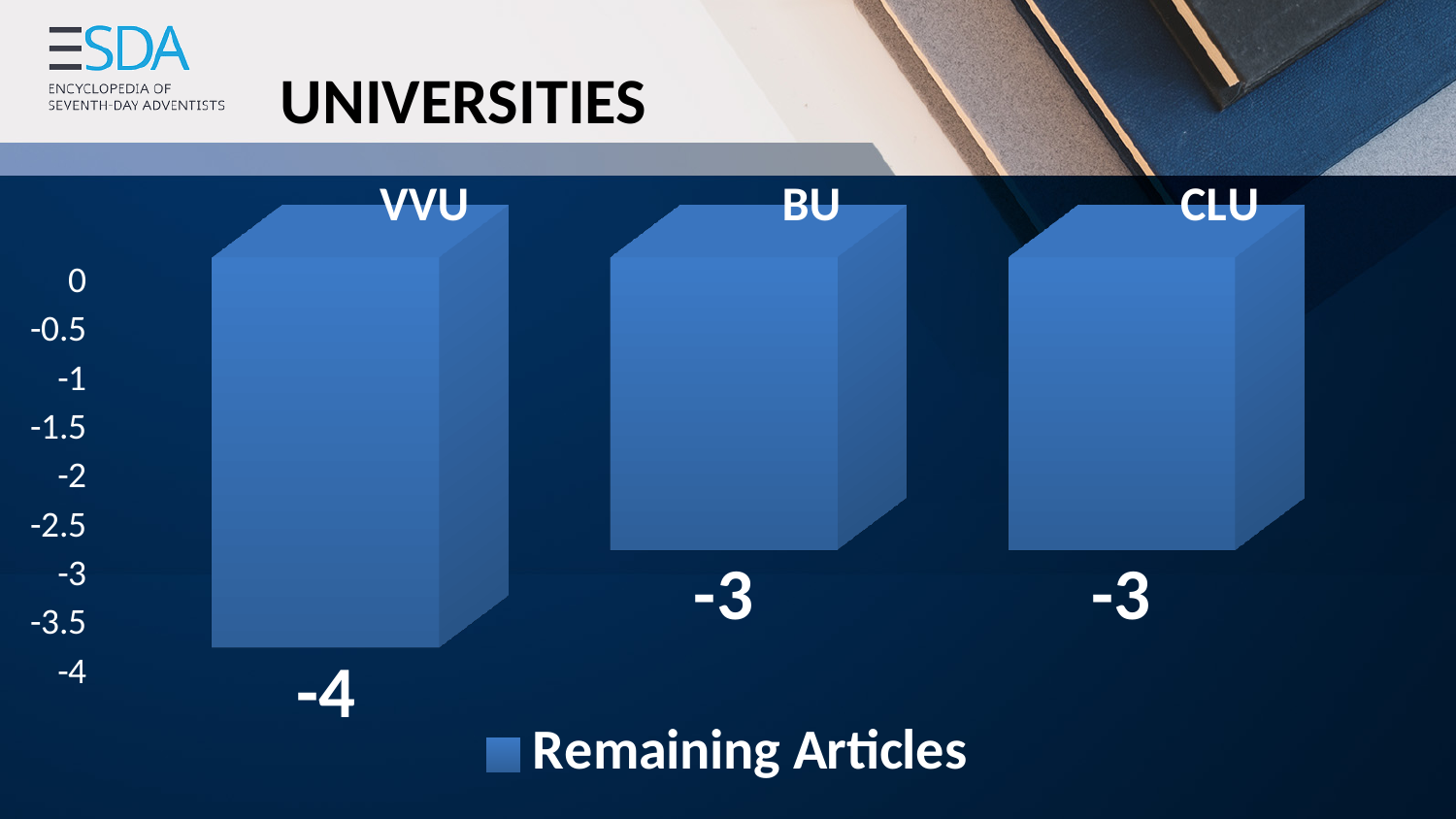
What is the title of the chart? UNIVERSITIES Which has the lower value, VVU or CLU? VVU How many categories are shown in the chart? 3 Which category has the lowest value? VVU What is the value for VVU? -4 What series name is shown in the legend? Remaining Articles What is the value for CLU? -3 What kind of chart is shown on the slide? Bar chart What is the difference between the values for VVU and BU? 1 What is the value for BU? -3 How many series does the legend list? 1 Is the value for BU greater or less than -3.5? greater